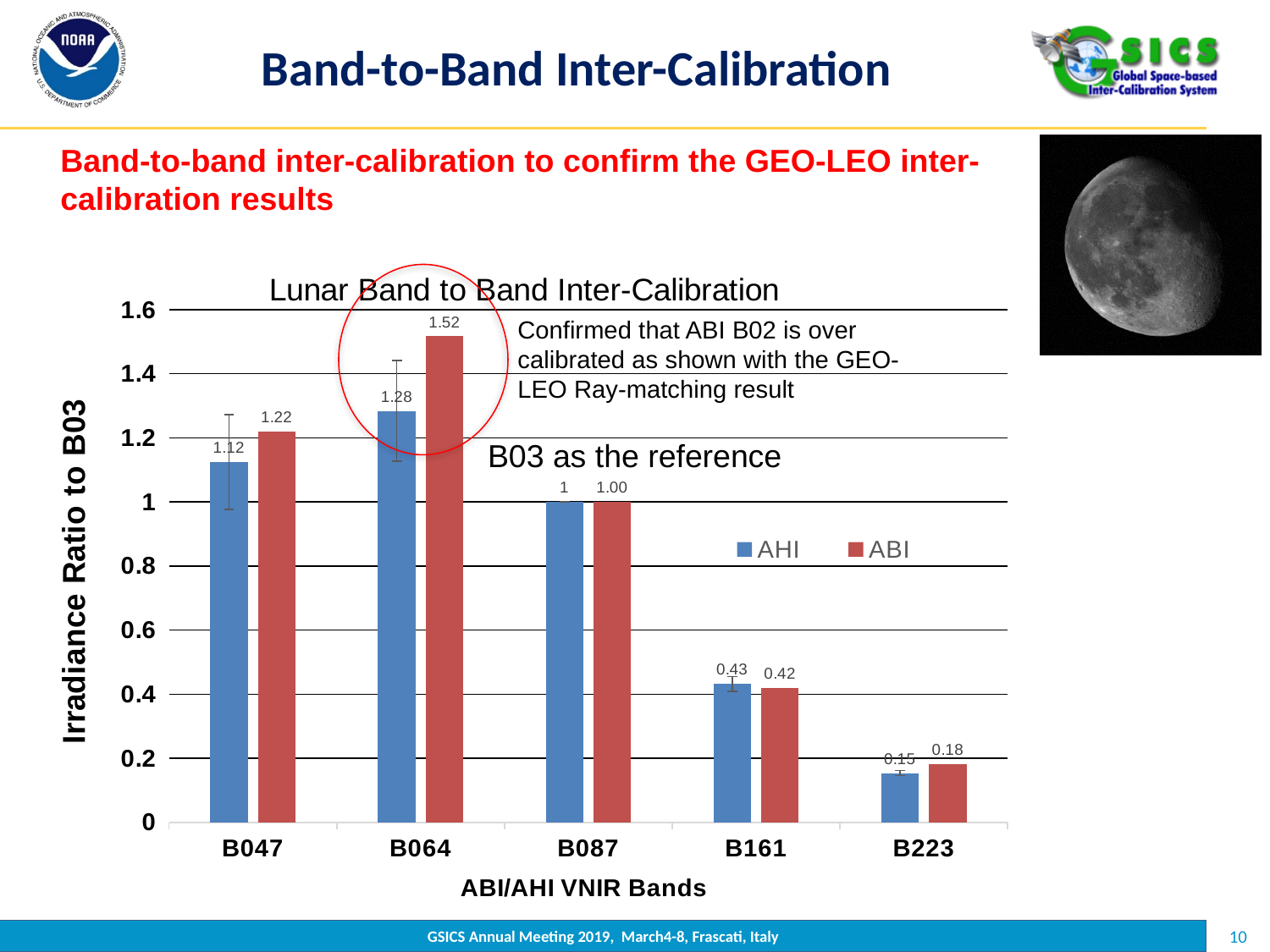
Which band has the highest ABI value? B064 What is the ABI value for B223? 0.18 What type of chart is shown on the slide? bar chart What is the label of the y axis? Irradiance Ratio to B03 What is the ABI value for B064? 1.52 What is the difference between the ABI and AHI values for B064? 0.24 Which band has the lowest AHI value? B223 How many series does the chart legend list? 2 What is the AHI value for B047? 1.12 What is the title of the chart? Lunar Band to Band Inter-Calibration For B047, which is larger, the AHI value or the ABI value? ABI How many bands are shown on the x axis of the chart? 5